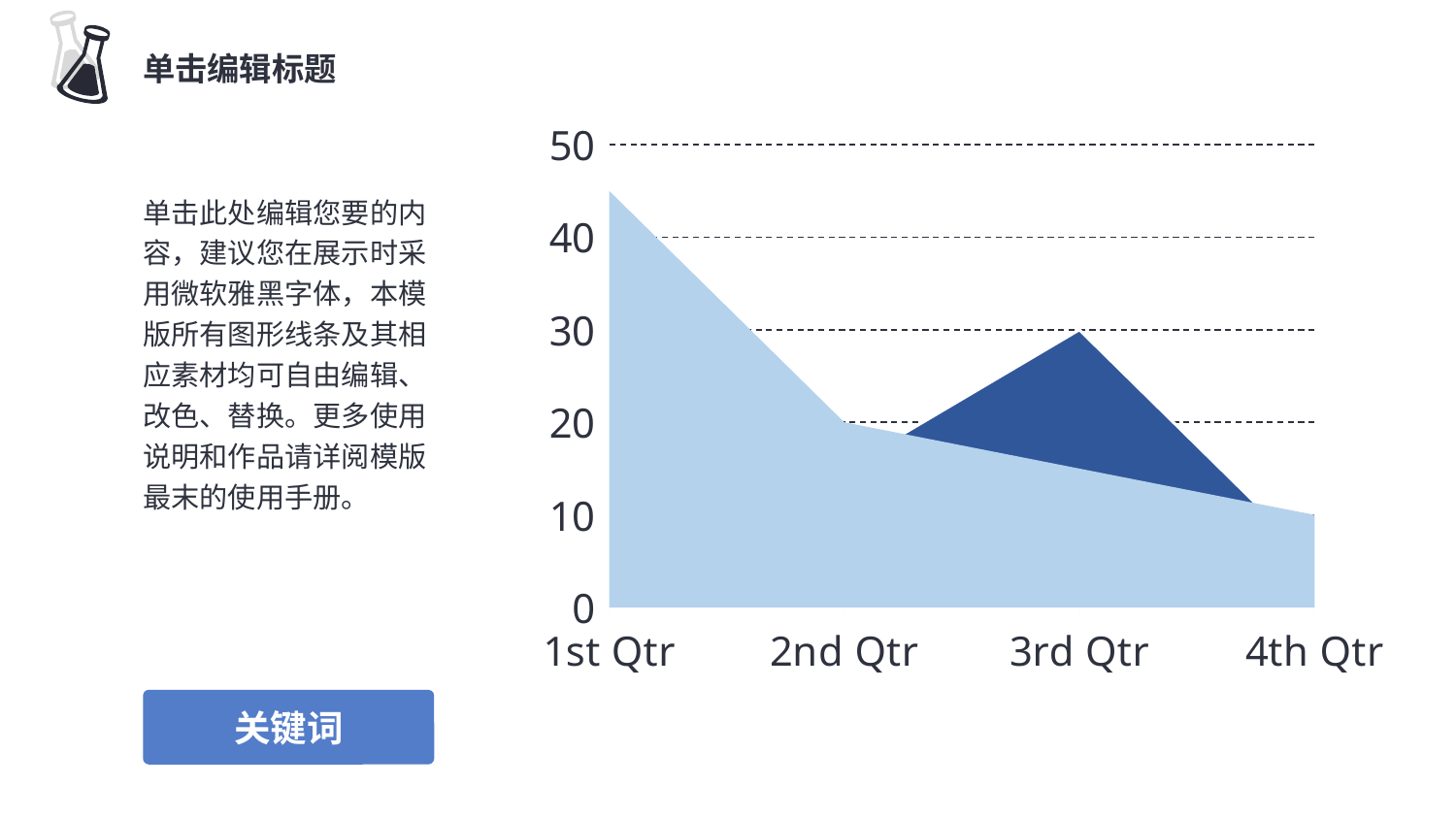
Which category has the lowest value for the light blue series? 4th Qtr How many categories are shown on the x axis of the chart? 4 What is the highest value shown on the vertical axis of the chart? 50 Is the value of the dark blue series for 3rd Qtr greater or less than 20? greater Is the value of the light blue series for 4th Qtr greater or less than 20? less Is the value of the light blue series for 1st Qtr greater or less than 40? greater For the light blue series, which is larger: the value for 1st Qtr or the value for 2nd Qtr? 1st Qtr Which category has the highest value for the light blue series? 1st Qtr Do the values of the light blue series rise or fall from 1st Qtr to 4th Qtr? fall What is the value of the dark blue series for 3rd Qtr? 30 Which category has the highest value for the dark blue series? 3rd Qtr What kind of chart is shown on the slide? area chart